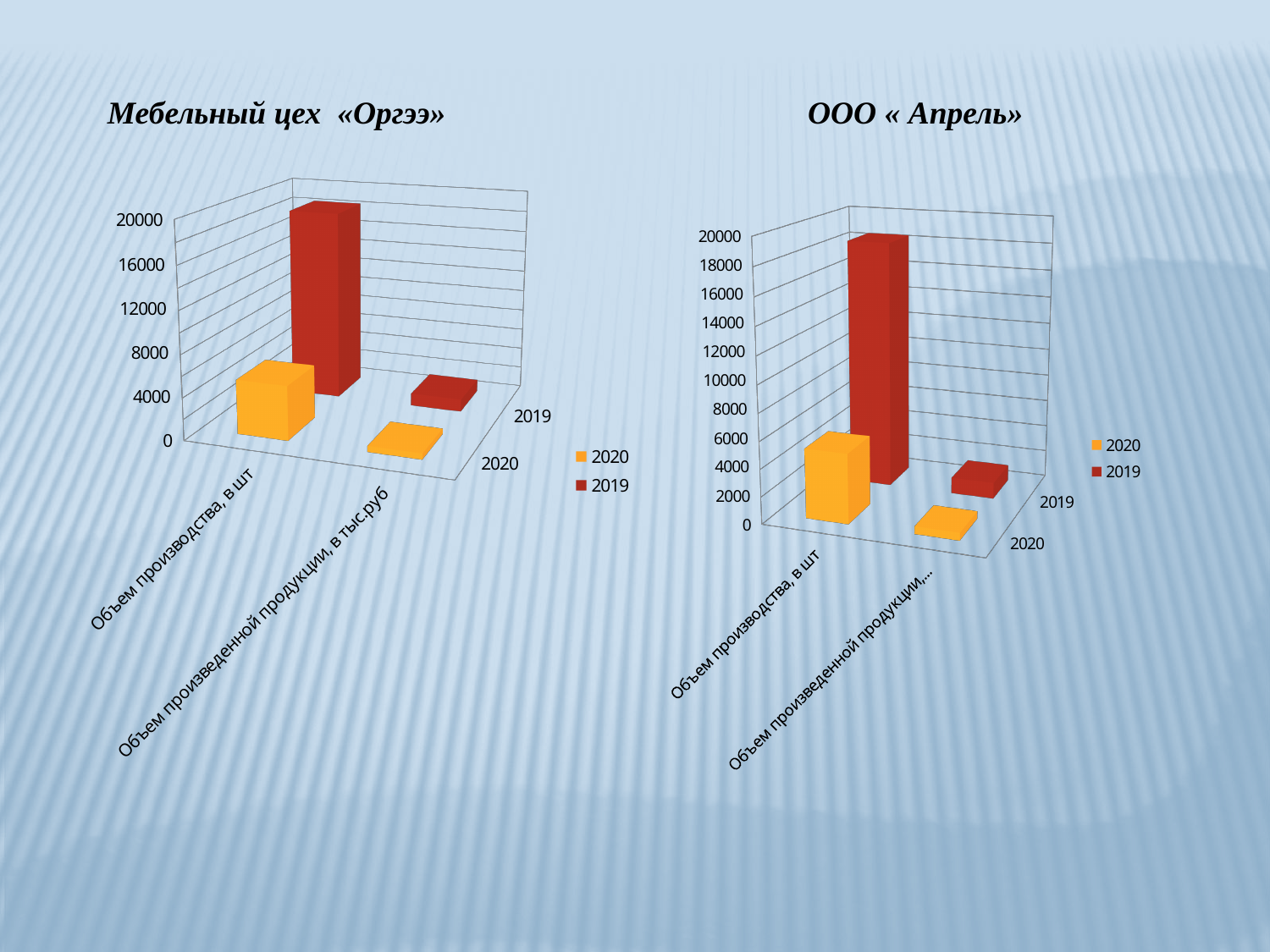
In the chart «ООО « Апрель»», which year has the larger value for «Объем производства, в шт», 2019 or 2020? 2019 In the chart «Мебельный цех «Оргээ»», is the 2020 value for «Объем производства, в шт» greater or less than 12000? less In the chart «Мебельный цех «Оргээ»», which colour represents the 2020 series? orange In the chart «ООО « Апрель»», is the 2019 value for «Объем производства, в шт» greater or less than 10000? greater In the chart «ООО « Апрель»», is the 2020 value for «Объем производства, в шт» greater or less than 10000? less In the chart «Мебельный цех «Оргээ»», which year has the larger value for «Объем производства, в шт», 2019 or 2020? 2019 In the chart «ООО « Апрель»», how many categories are shown on the x axis? 2 What is the title of the chart on the right side of the slide? ООО « Апрель» What kind of chart is shown under the title «Мебельный цех «Оргээ»»? bar chart In the chart «Мебельный цех «Оргээ»», how many series does the legend list? 2 In the chart «ООО « Апрель»», which series has the tallest bar overall? 2019